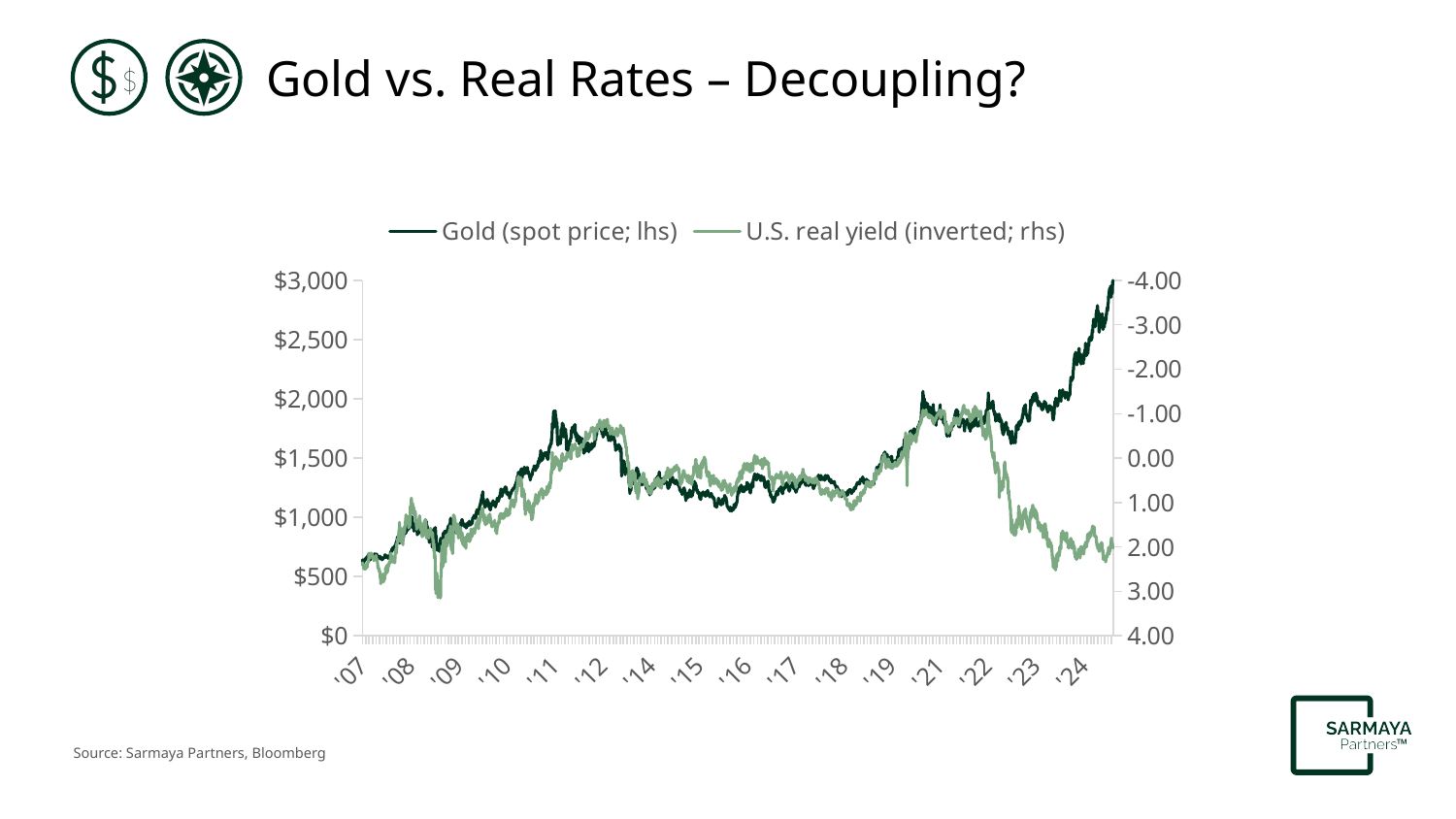
Is the gold spot price higher at the end of 2024 or at the start of 2007? End of 2024 Does the gold spot price rise or fall from 2012 to 2014? fall What are the two series named in the legend? Gold (spot price; lhs) and U.S. real yield (inverted; rhs) Is the gold spot price at the end of 2024 greater or less than $2,500? greater What kind of chart is shown on the slide? Line chart Is the gold spot price at its 2011 peak greater or less than $1,500? greater Does the gold spot price rise or fall from 2022 to the end of 2024? rise Is the gold spot price at the start of 2007 greater or less than $1,000? less How many series does the legend list? 2 What is the title of the slide containing the chart? Gold vs. Real Rates – Decoupling?